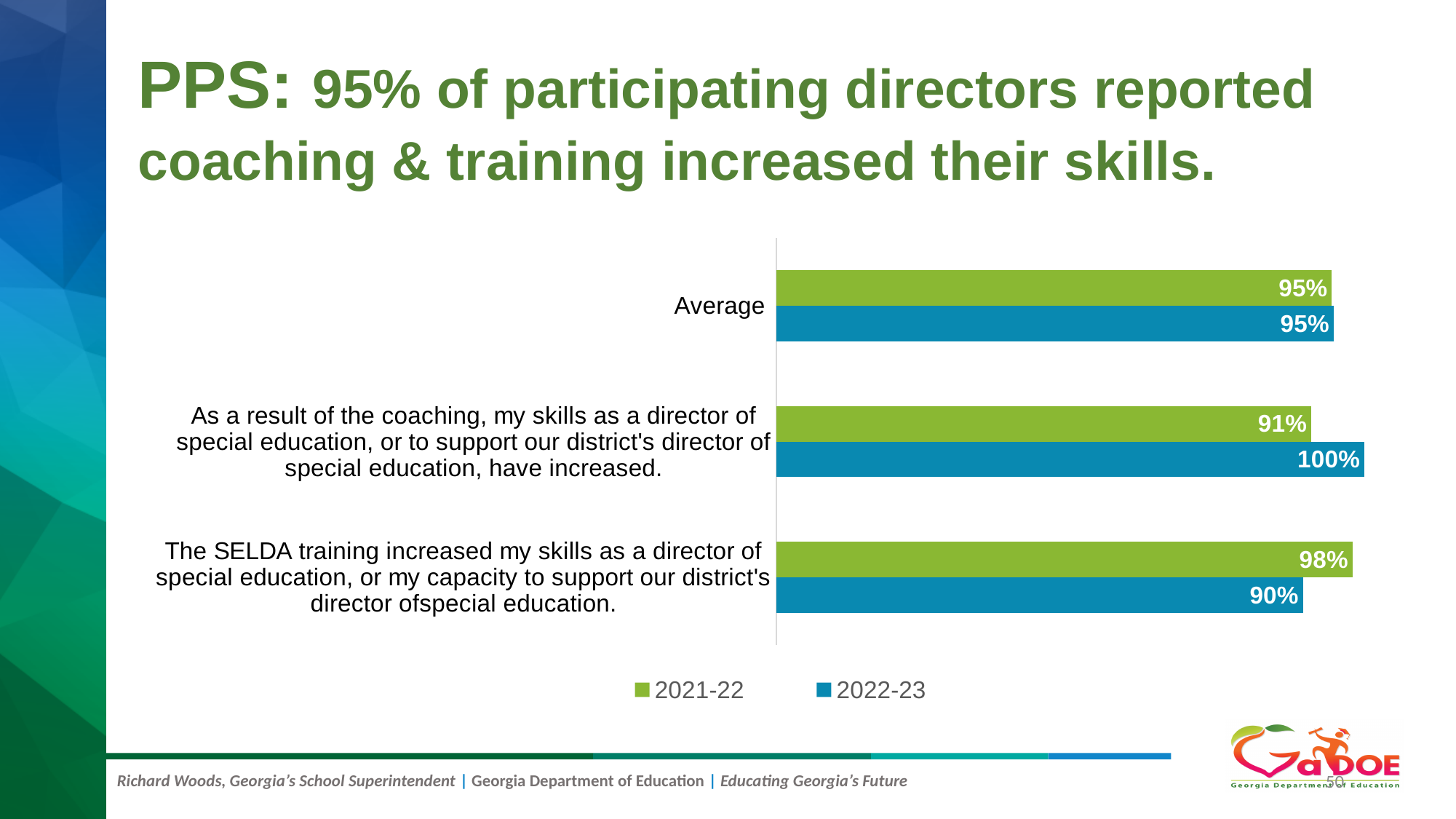
What is the difference between the 2021-22 and 2022-23 values for the SELDA training statement? 8% How many series does the legend list? 2 What is the 2021-22 value for the Average category? 95% What is the 2021-22 value for the SELDA training statement? 98% What kind of chart is shown on the slide? Bar chart Which category has the lowest 2021-22 value? As a result of the coaching, my skills as a director of special education, or to support our district's director of special education, have increased. Which series is shown in green in the legend? 2021-22 For the coaching statement, which series has the larger value, 2021-22 or 2022-23? 2022-23 What is the 2022-23 value for the coaching statement? 100% How many categories are shown on the chart? 3 Which category has the highest 2022-23 value? As a result of the coaching, my skills as a director of special education, or to support our district's director of special education, have increased. What is the 2022-23 value for the SELDA training statement? 90%